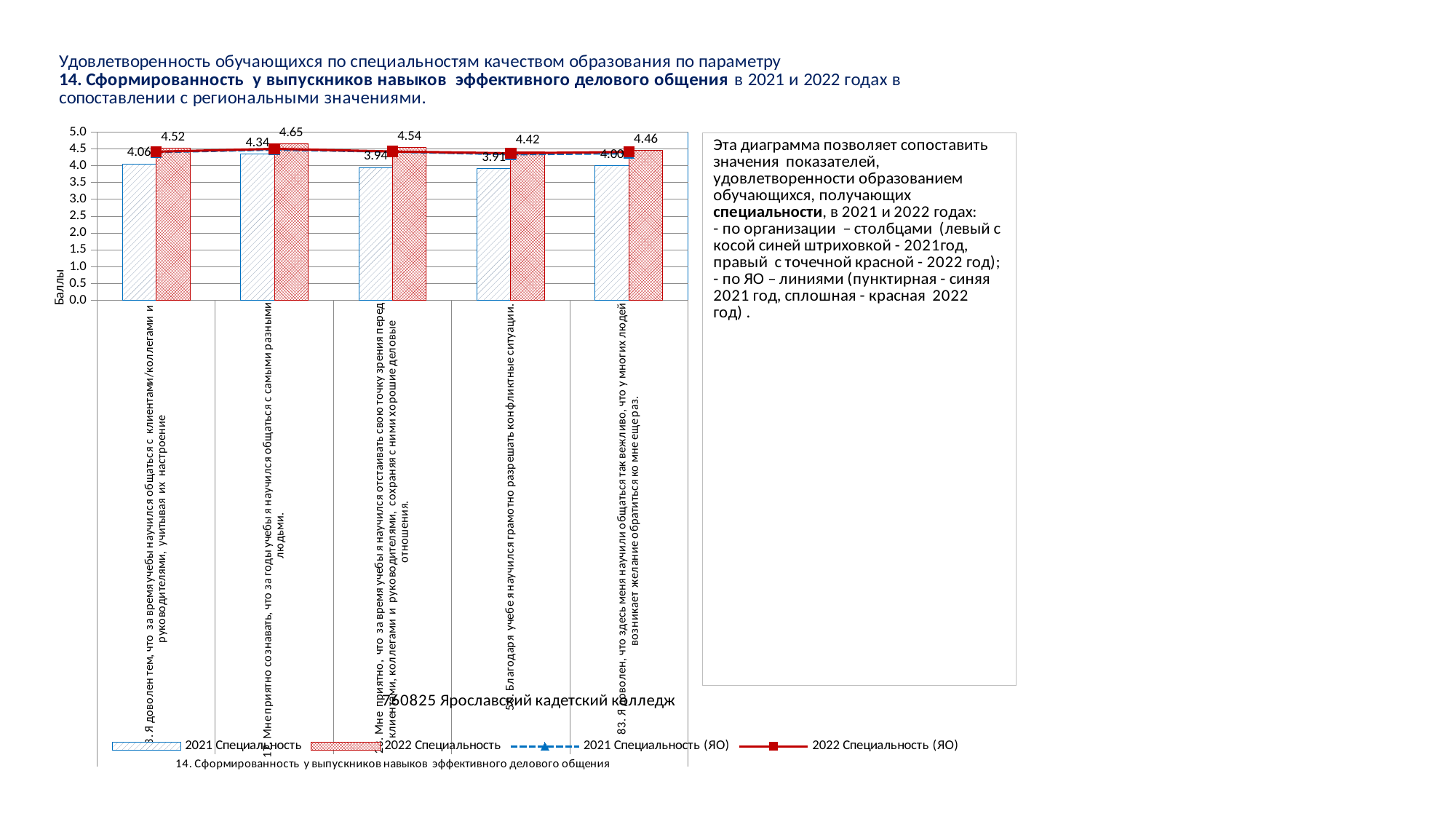
For the last category ("Я доволен, что здесь меня научили общаться так вежливо..."), which is larger: the 2021 Специальность value or the 2022 Специальность value? 2022 Специальность (4.46) How many categories are shown on the x axis of the chart? 5 What is the difference between the 2022 Специальность and 2021 Специальность values for the first category (общаться с клиентами/коллегами и руководителями, учитывая их настроение)? 0.46 What is the value of the 2022 Специальность bar for the category "Я доволен тем, что за время учебы научился общаться с клиентами/коллегами и руководителями, учитывая их настроение"? 4.52 What is the value of the 2021 Специальность bar for the category "Благодаря учебе я научился грамотно разрешать конфликтные ситуации"? 3.91 What is the value of the 2022 Специальность bar for the last category, "Я доволен, что здесь меня научили общаться так вежливо, что у многих людей возникает желание обратиться ко мне еще раз"? 4.46 Which category has the highest 2022 Специальность value? Мне приятно сознавать, что за годы учебы я научился общаться с самыми разными людьми (4.65) What is the difference between the 2022 Специальность and 2021 Специальность values for the category "Мне приятно сознавать, что за годы учебы я научился общаться с самыми разными людьми"? 0.31 What is the title of the vertical axis of the chart? Баллы How many series does the chart legend list? 4 What is the value of the 2021 Специальность bar for the category "Я доволен тем, что за время учебы научился общаться с клиентами/коллегами и руководителями, учитывая их настроение"? 4.06 Which category has the lowest 2021 Специальность value? Благодаря учебе я научился грамотно разрешать конфликтные ситуации (3.91)